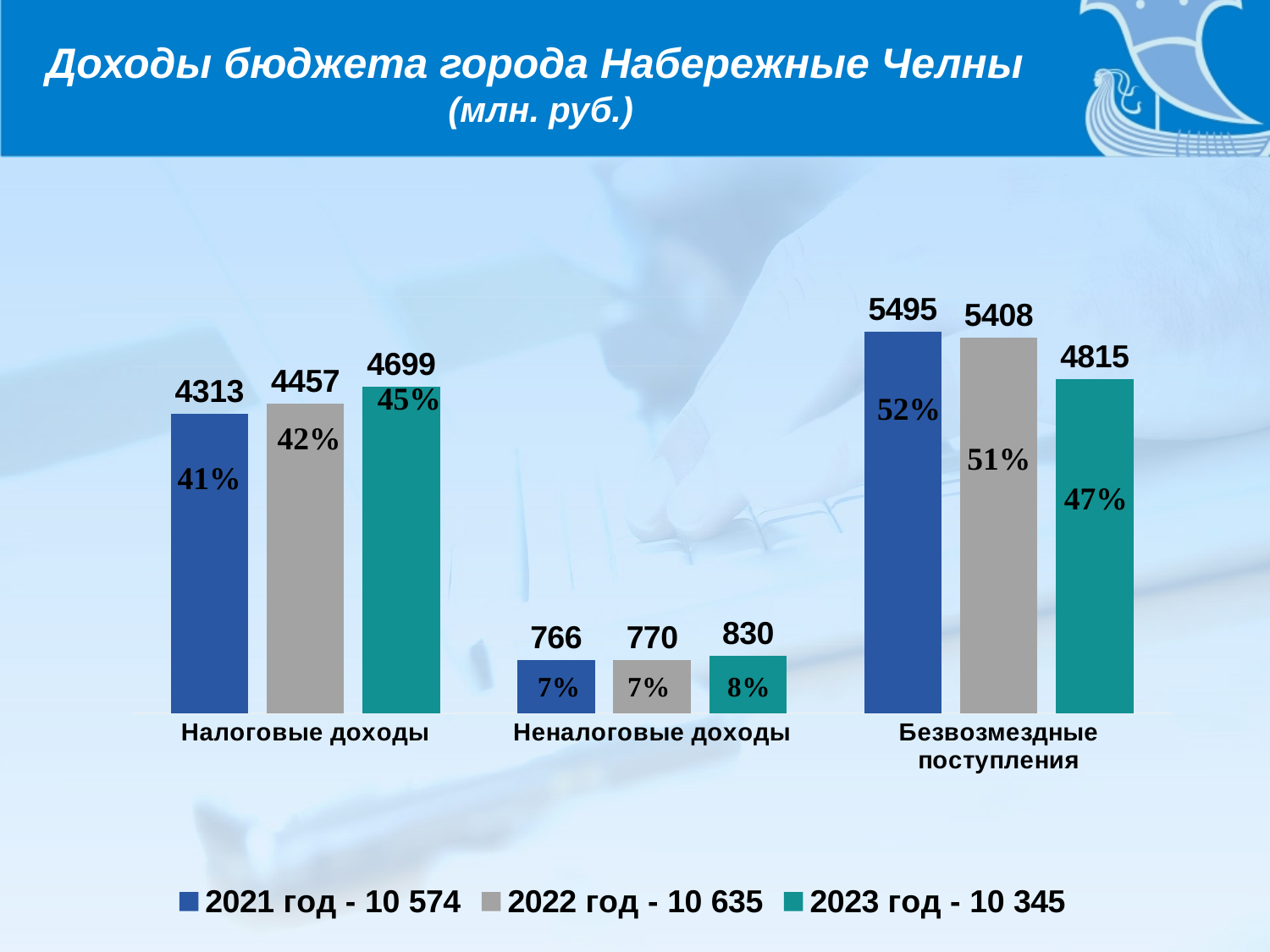
What is the value for Безвозмездные поступления in the 2023 год series? 4815 How many categories are shown on the x axis? 3 What is the difference between the 2023 год and 2021 год values for Налоговые доходы? 386 What percentage share is printed on the 2022 год bar for Безвозмездные поступления? 51% Do the values for Неналоговые доходы rise or fall from 2021 год to 2023 год? Rise Which is larger for Безвозмездные поступления: the 2021 год value or the 2022 год value? 2021 год Which category has the highest value in the 2021 год series? Безвозмездные поступления What is the value for Налоговые доходы in the 2021 год series? 4313 What kind of chart is shown on the slide? Bar chart Which category has the lowest value in the 2023 год series? Неналоговые доходы What is the value for Неналоговые доходы in the 2022 год series? 770 How many series does the legend list? 3